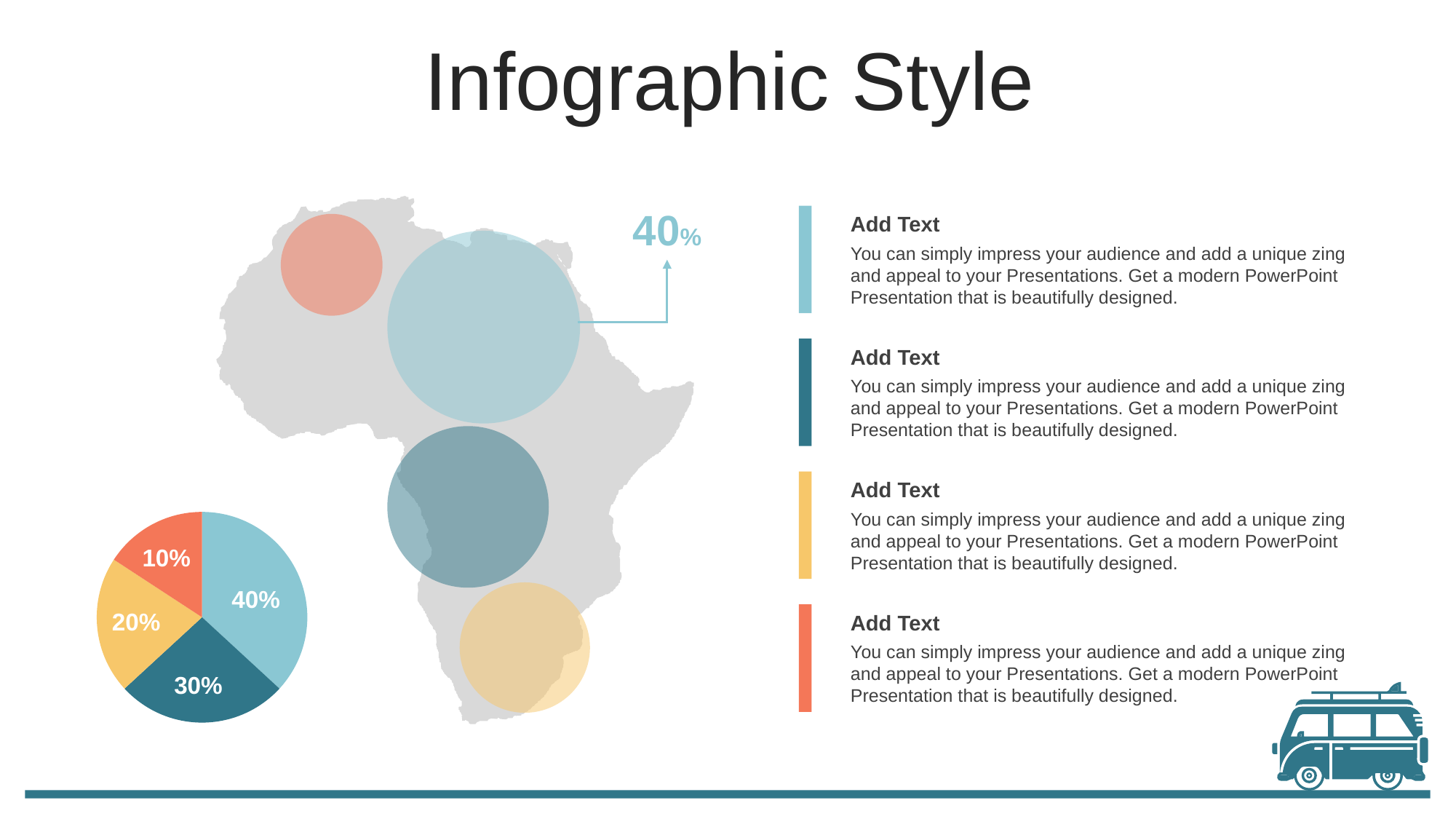
What percentage is labelled on the callout pointing to the large light blue circle on the map of Africa? 40% What is the value of the largest slice in the pie chart? 40% How many slices does the pie chart have? 4 What value is shown on the dark teal slice of the pie chart? 30% What kind of chart is shown at the bottom left of the slide? pie chart What colour is the 20% slice of the pie chart? yellow What is the difference between the largest and smallest slices of the pie chart? 30% What value is shown on the light blue slice of the pie chart? 40% What value is shown on the red slice of the pie chart? 10% What is the value of the smallest slice in the pie chart? 10% What value is shown on the yellow slice of the pie chart? 20% Which slice of the pie chart is larger, the yellow one or the dark teal one? the dark teal one